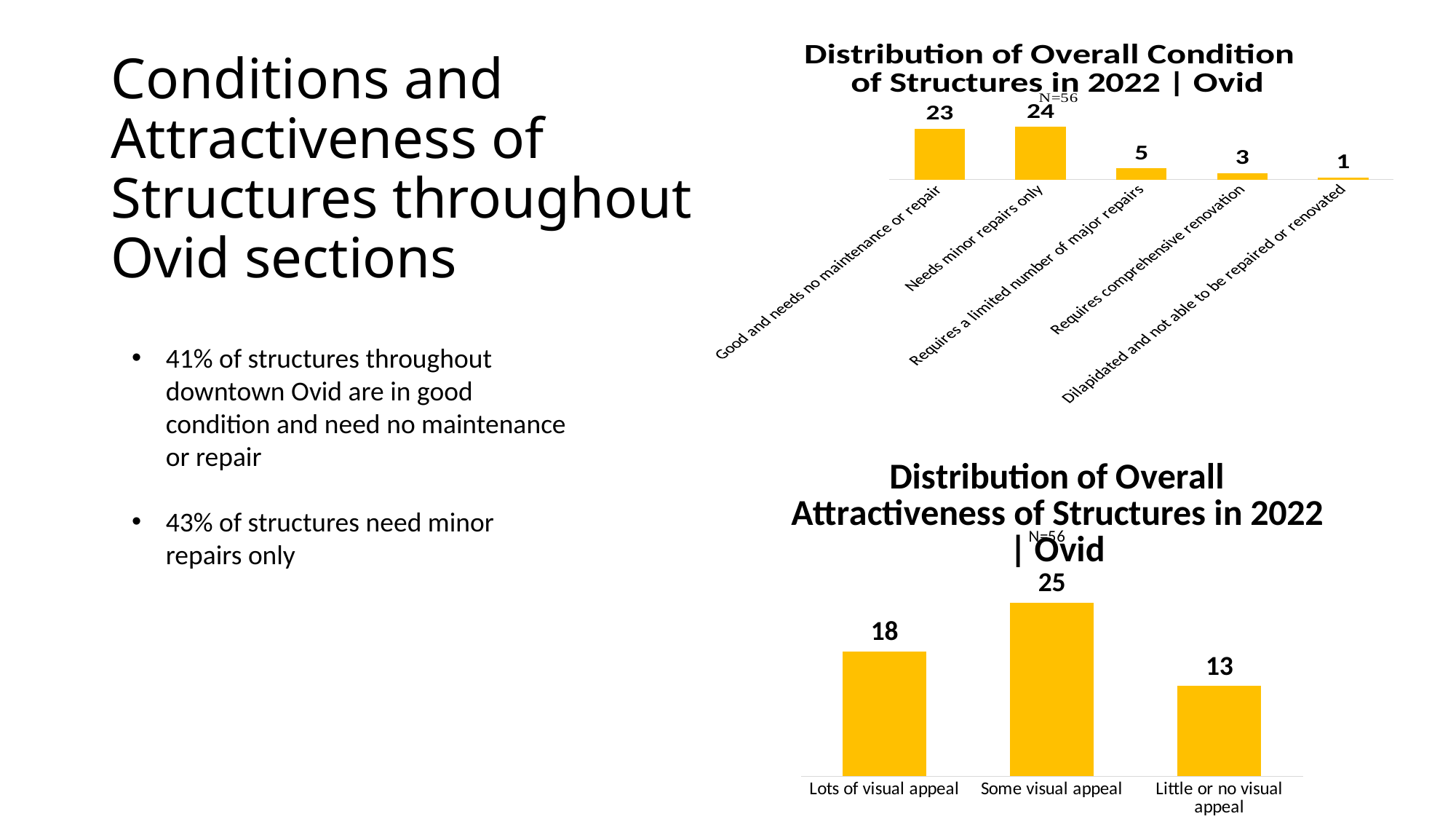
In the 'Distribution of Overall Attractiveness of Structures in 2022 | Ovid' chart, which category has the highest value? Some visual appeal In the 'Distribution of Overall Condition of Structures in 2022 | Ovid' chart, what is the difference between 'Requires a limited number of major repairs' and 'Requires comprehensive renovation'? 2 In the 'Distribution of Overall Attractiveness of Structures in 2022 | Ovid' chart, what is the value for 'Some visual appeal'? 25 In the 'Distribution of Overall Attractiveness of Structures in 2022 | Ovid' chart, what is the difference between 'Lots of visual appeal' and 'Little or no visual appeal'? 5 In the 'Distribution of Overall Condition of Structures in 2022 | Ovid' chart, what is the value for 'Good and needs no maintenance or repair'? 23 What kind of chart is the 'Distribution of Overall Attractiveness of Structures in 2022 | Ovid' chart? Bar chart In the 'Distribution of Overall Condition of Structures in 2022 | Ovid' chart, what is the value for 'Needs minor repairs only'? 24 In the 'Distribution of Overall Condition of Structures in 2022 | Ovid' chart, what is the value for 'Requires comprehensive renovation'? 3 In the 'Distribution of Overall Attractiveness of Structures in 2022 | Ovid' chart, how many categories are shown? 3 In the 'Distribution of Overall Condition of Structures in 2022 | Ovid' chart, how many categories are shown? 5 In the 'Distribution of Overall Attractiveness of Structures in 2022 | Ovid' chart, which is larger: 'Lots of visual appeal' or 'Little or no visual appeal'? Lots of visual appeal In the 'Distribution of Overall Condition of Structures in 2022 | Ovid' chart, which category has the lowest value? Dilapidated and not able to be repaired or renovated